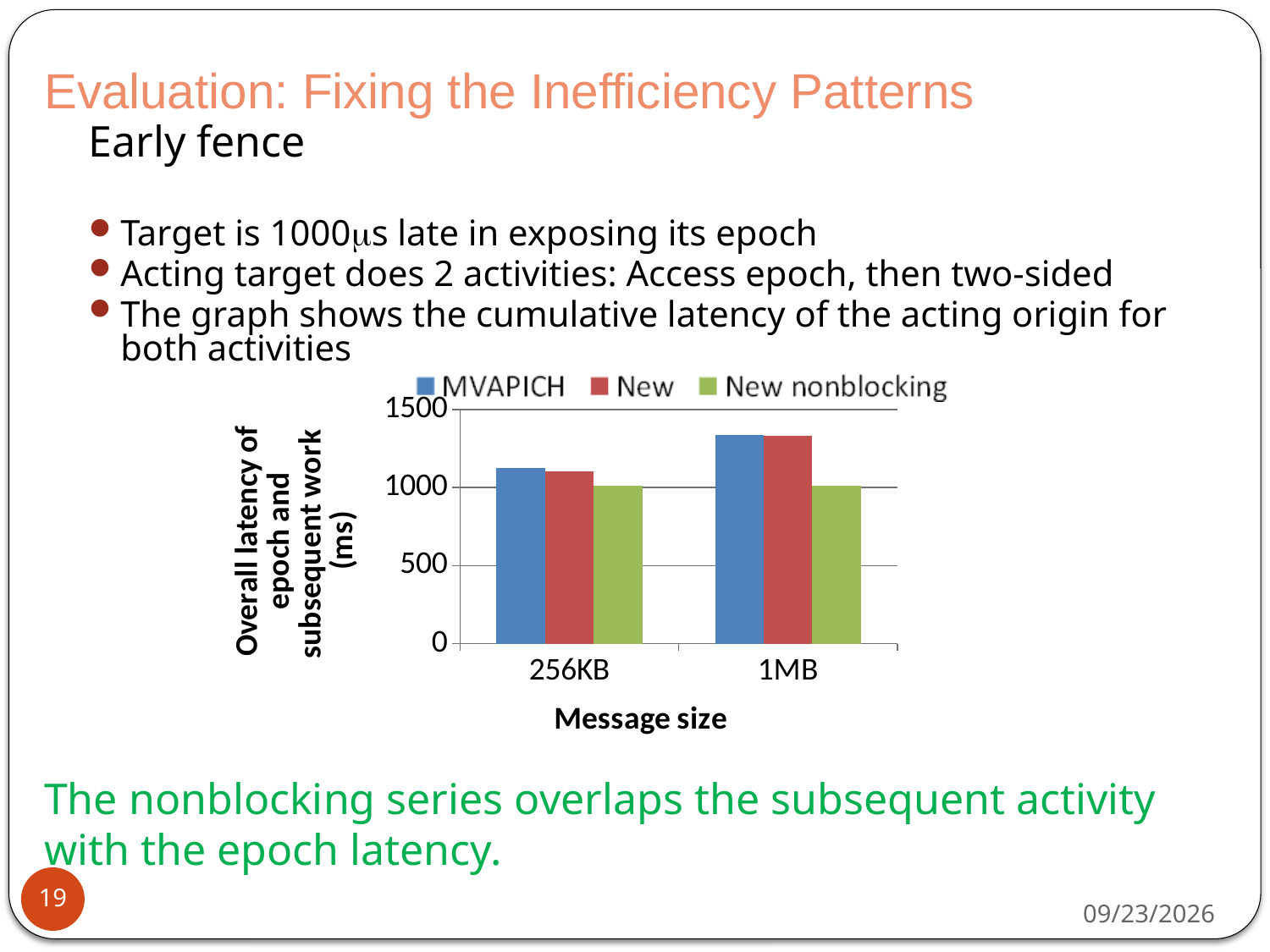
What is the label of the x axis? Message size What kind of chart is shown on the slide? bar chart At 1MB, which is larger: MVAPICH or New nonblocking? MVAPICH Is the value for New at 1MB greater or less than 1000? greater How many message size categories are shown on the x axis? 2 How many series does the legend list? 3 Which series has the lowest value at 1MB? New nonblocking Does the MVAPICH value rise or fall from 256KB to 1MB? rise Is the value for MVAPICH at 256KB greater or less than 1000? greater Is the value for MVAPICH at 1MB greater or less than 1500? less Which series is shown in green in the legend? New nonblocking